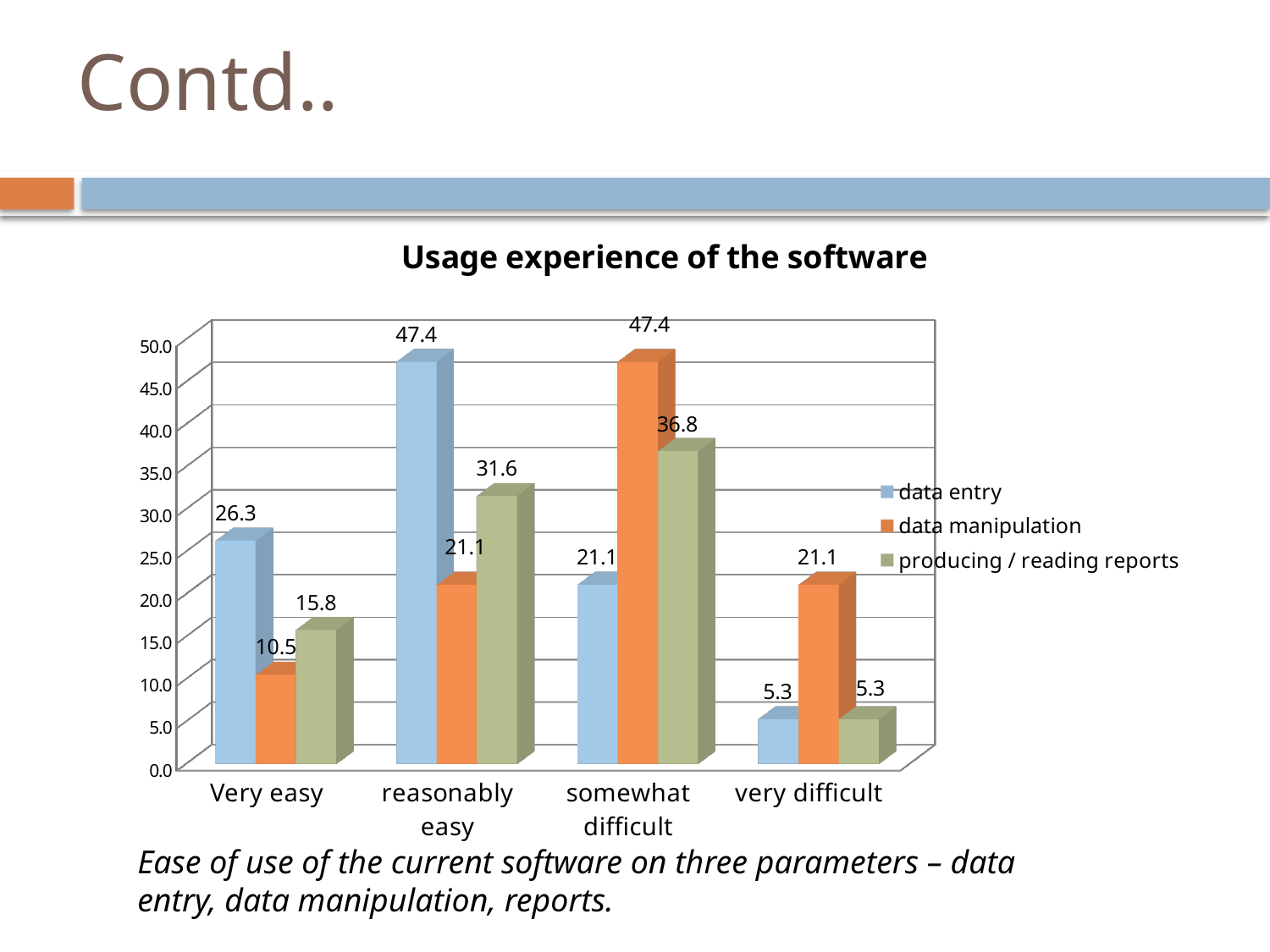
What kind of chart is shown on the slide? bar chart What is the difference between the data entry and data manipulation values in the Very easy category? 15.8 How many categories are shown on the x axis? 4 What is the title of the chart? Usage experience of the software How many series does the legend list? 3 What is the value for data entry in the Very easy category? 26.3 Which category has the highest value for data entry? reasonably easy What is the value for producing / reading reports in the reasonably easy category? 31.6 Which is larger in the somewhat difficult category: data entry or producing / reading reports? producing / reading reports What is the value for data manipulation in the somewhat difficult category? 47.4 What is the value for data manipulation in the very difficult category? 21.1 Which category has the lowest value for producing / reading reports? very difficult